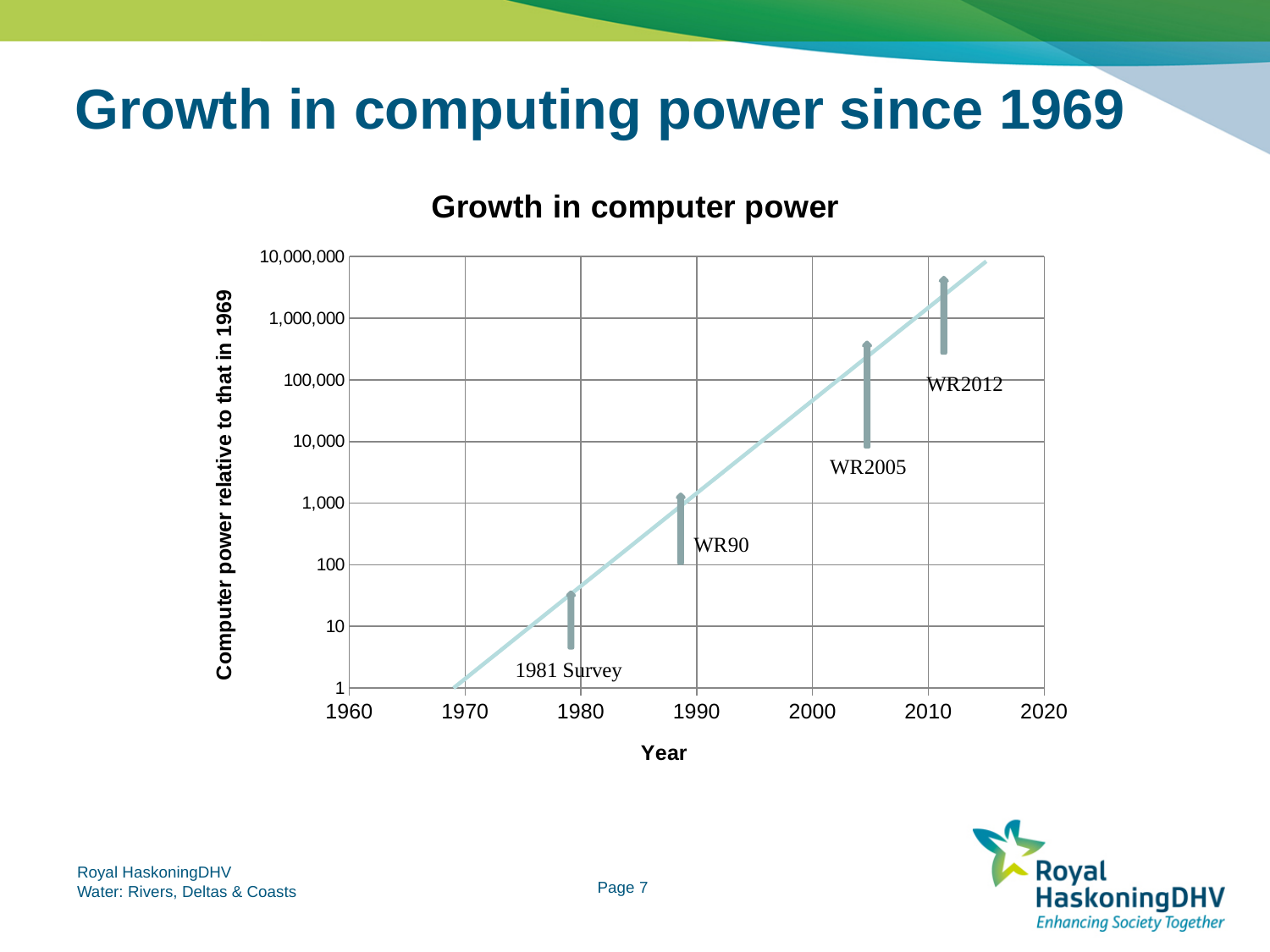
Is the value for the 1981 Survey greater or less than 100? less What is the title of the chart? Growth in computer power What is the label of the vertical axis of the chart? Computer power relative to that in 1969 Which has the larger computer power value, WR2005 or WR90? WR2005 Which labelled data point has the lowest computer power value? 1981 Survey Which labelled data point has the highest computer power value? WR2012 Is the value for WR90 greater or less than 10,000? less How many labelled data points are shown on the chart? 4 Is the value for WR2005 greater or less than 1,000? greater What is the earliest year shown on the x axis of the chart? 1960 Does computer power rise or fall as the year increases along the x axis? rise